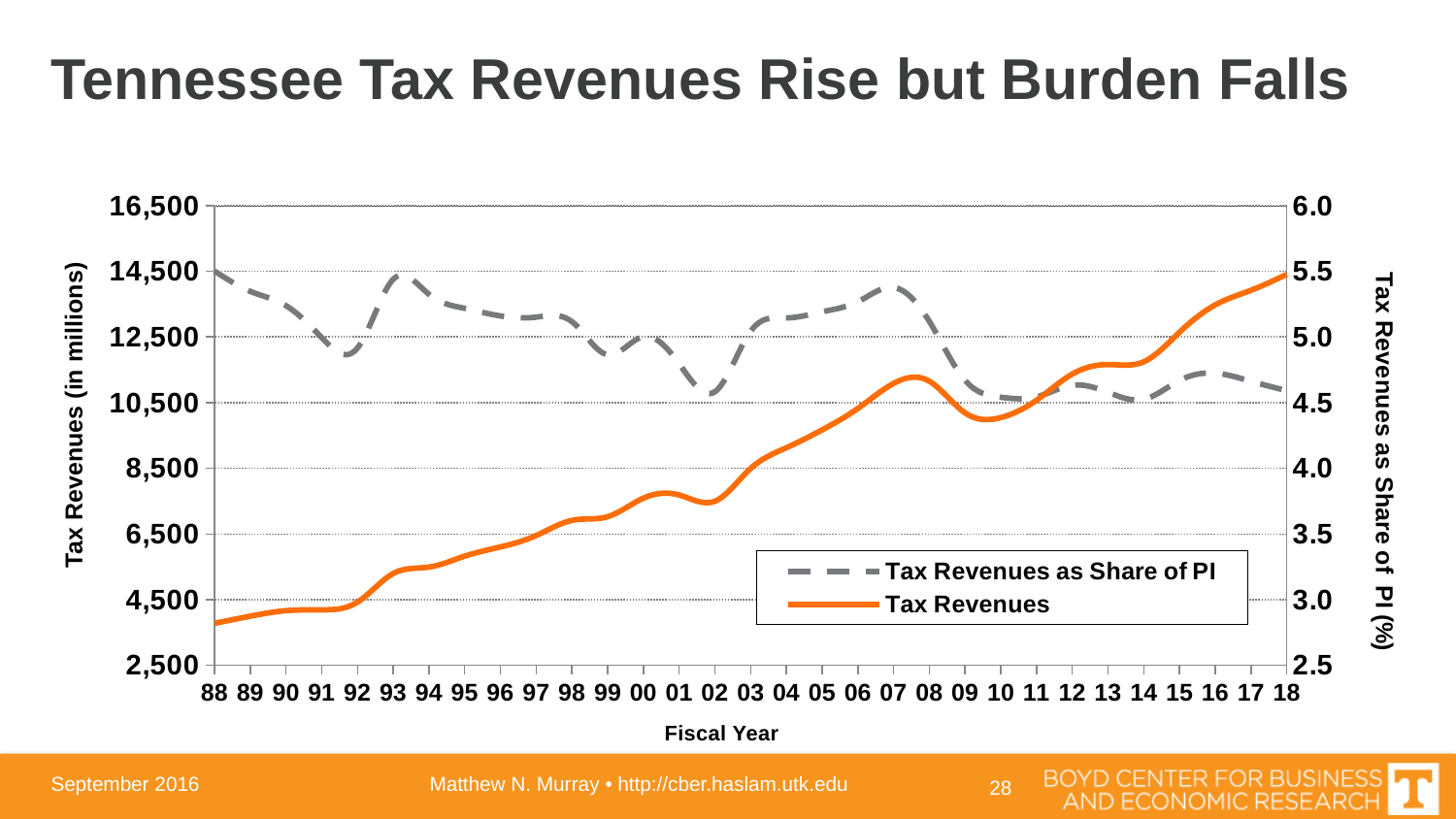
Which fiscal year has the highest Tax Revenues? 18 Is the Tax Revenues value for fiscal year 88 greater or less than 4,500? less What is the title of the left vertical axis? Tax Revenues (in millions) How many series does the legend list? 2 Is the Tax Revenues value for fiscal year 18 greater or less than 12,500? greater Is the Tax Revenues as Share of PI value for fiscal year 09 greater or less than 5.0? less What kind of chart is shown on the slide? line chart Does Tax Revenues as Share of PI generally rise or fall from fiscal year 88 to 18? fall Which is larger, Tax Revenues as Share of PI in fiscal year 88 or in fiscal year 18? 88 How many fiscal years are plotted along the x axis? 31 Which fiscal year has the lowest Tax Revenues? 88 Do Tax Revenues generally rise or fall from fiscal year 88 to 18? rise